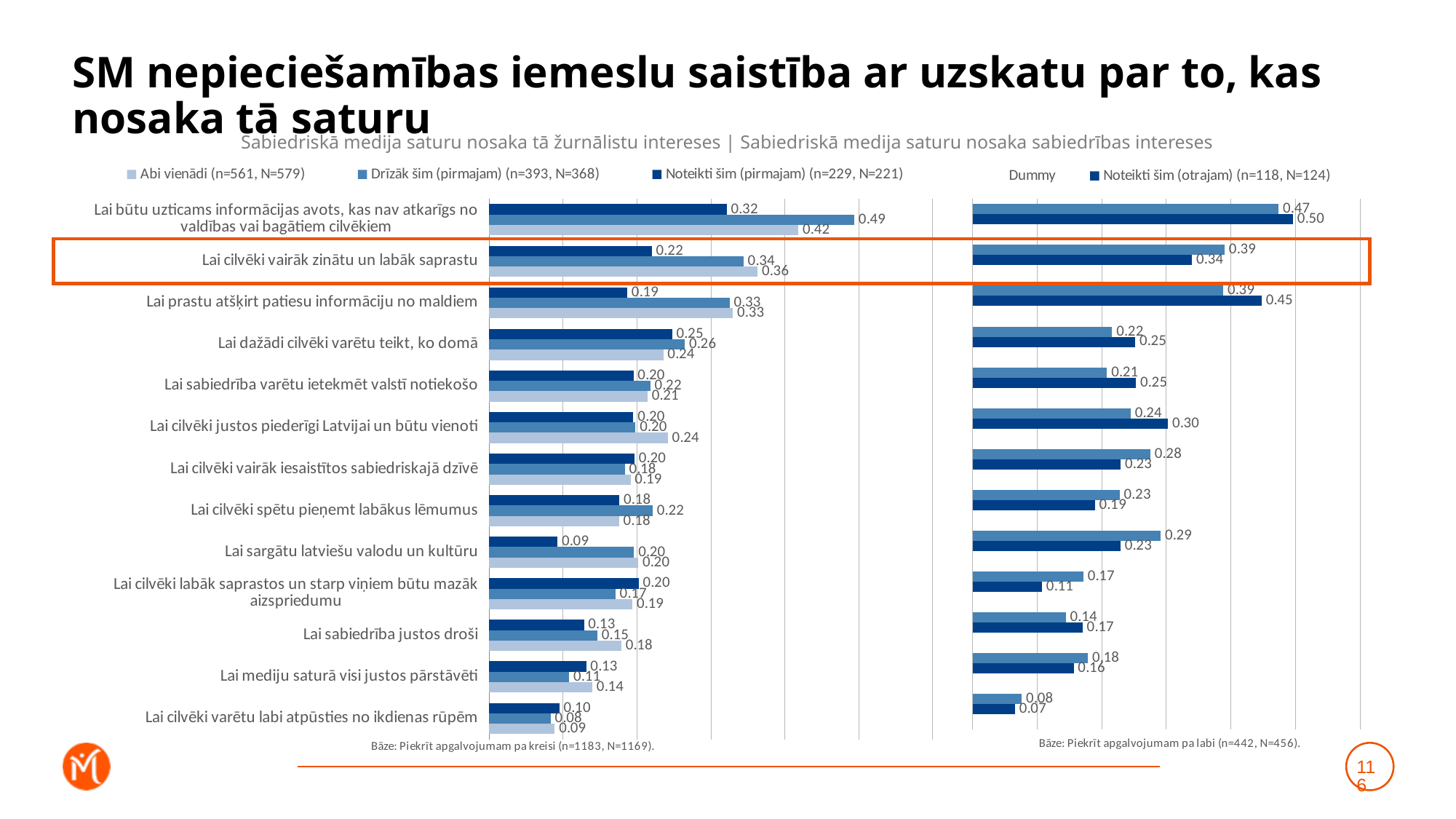
How many categories (reasons) are listed on the chart? 13 In the left panel, what is the difference between 'Drīzāk šim (pirmajam)' and 'Noteikti šim (pirmajam)' for 'Lai būtu uzticams informācijas avots, kas nav atkarīgs no valdības vai bagātiem cilvēkiem'? 0.17 In the left panel, what is the value of 'Abi vienādi' for 'Lai cilvēki vairāk zinātu un labāk saprastu'? 0.36 What kind of chart is shown on the slide? bar chart In the right panel, what is the value of 'Noteikti šim (otrajam)' for 'Lai prastu atšķirt patiesu informāciju no maldiem'? 0.45 In the left panel, what is the value of 'Drīzāk šim (pirmajam)' for 'Lai būtu uzticams informācijas avots, kas nav atkarīgs no valdības vai bagātiem cilvēkiem'? 0.49 In the left panel, what is the value of 'Noteikti šim (pirmajam)' for 'Lai sargātu latviešu valodu un kultūru'? 0.09 Which category on the chart is highlighted with an orange box? Lai cilvēki vairāk zinātu un labāk saprastu In the right panel, which category has the highest value for 'Noteikti šim (otrajam)'? Lai būtu uzticams informācijas avots, kas nav atkarīgs no valdības vai bagātiem cilvēkiem In the left panel, which is larger for 'Lai sabiedrība justos droši': 'Abi vienādi' or 'Noteikti šim (pirmajam)'? Abi vienādi How many series does the legend list? 5 In the left panel, which category has the lowest value for 'Noteikti šim (pirmajam)'? Lai sargātu latviešu valodu un kultūru